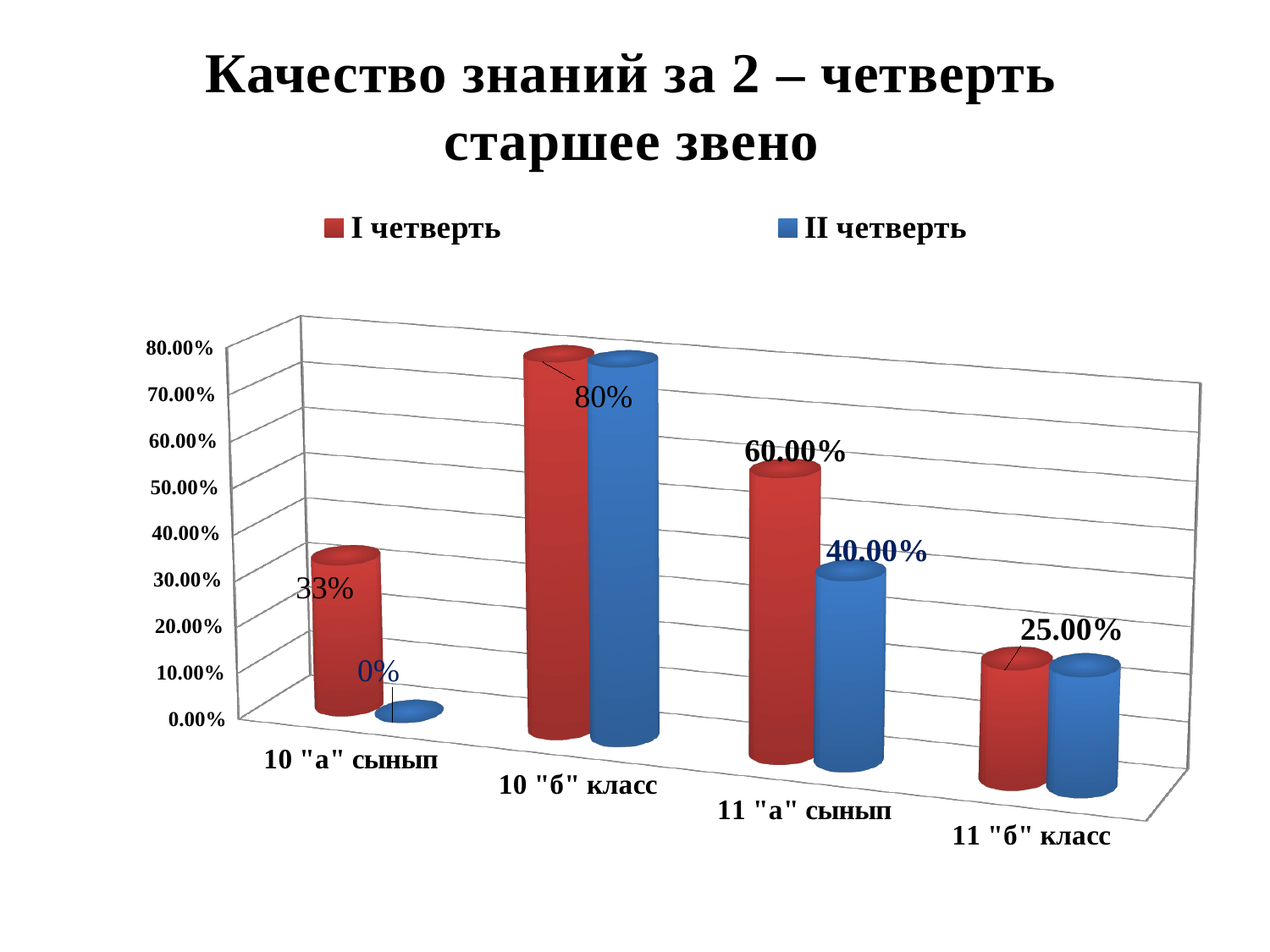
Is the II четверть value for 10 "б" класс greater or less than 70.00%? greater What is the value for 10 "а" сынып in the I четверть series? 33% Which category has the lowest value in the II четверть series? 10 "а" сынып What is the value for 10 "а" сынып in the II четверть series? 0% What is the value for 11 "а" сынып in the I четверть series? 60.00% What is the difference between the I четверть and II четверть values for 11 "а" сынып? 20.00% What is the value for 10 "б" класс in the I четверть series? 80% What is the value for 11 "а" сынып in the II четверть series? 40.00% How many categories are shown on the x axis? 4 What is the value for 11 "б" класс in the I четверть series? 25.00% How many series does the legend list? 2 Which category has the highest value in the I четверть series? 10 "б" класс